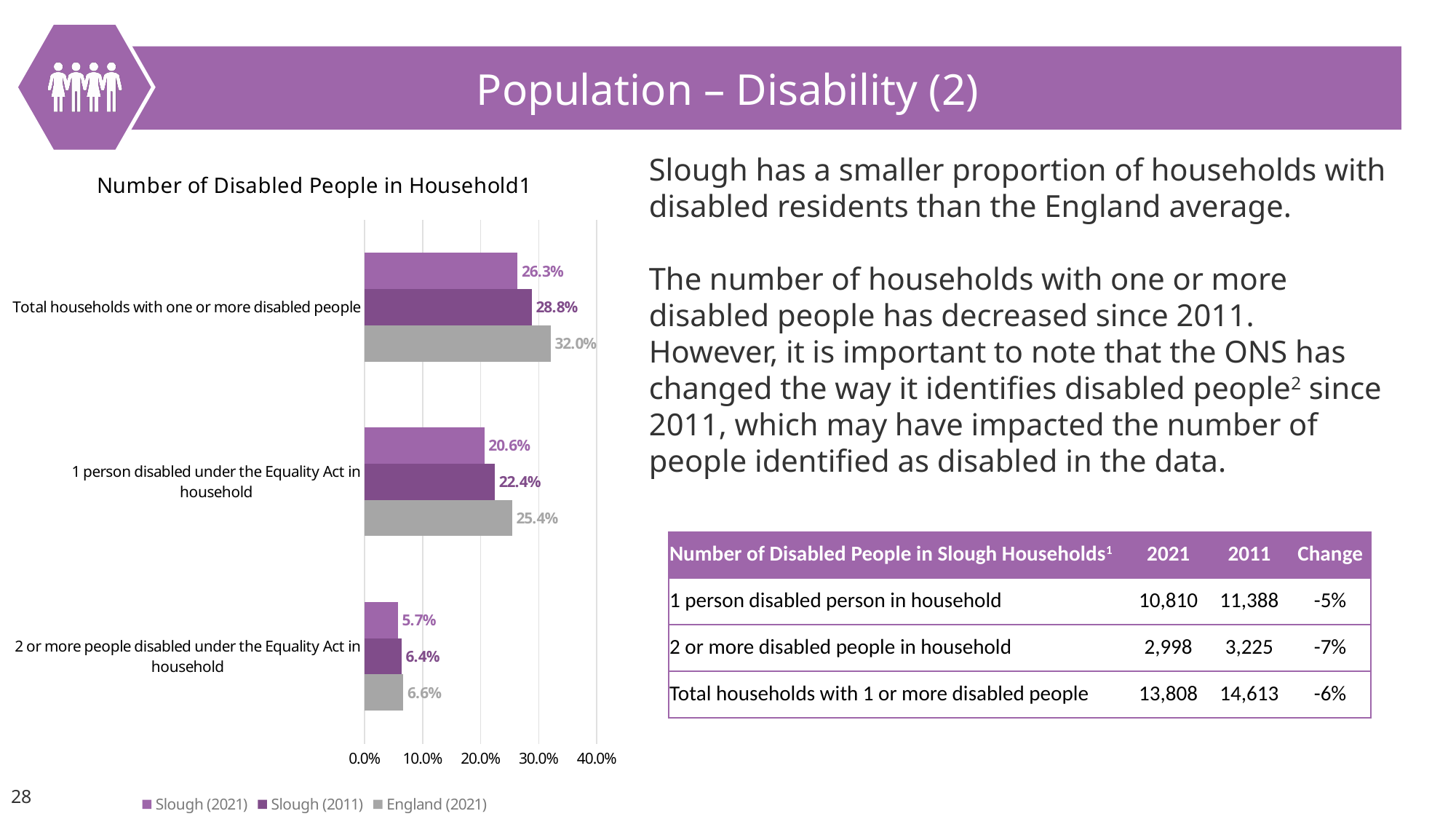
How many series does the legend list? 3 Which category has the lowest Slough (2021) value? 2 or more people disabled under the Equality Act in household Which is larger for '1 person disabled under the Equality Act in household': Slough (2021) or Slough (2011)? Slough (2011) What is the difference between the England (2021) and Slough (2021) values for 'Total households with one or more disabled people'? 5.7% What is the Slough (2021) value for 'Total households with one or more disabled people'? 26.3% How many categories are shown on the chart? 3 Is the Slough (2011) value for 'Total households with one or more disabled people' greater or less than 30.0%? less What kind of chart is shown on the slide? bar chart What is the title of the chart? Number of Disabled People in Household1 Which series has the highest value for 'Total households with one or more disabled people'? England (2021) What is the England (2021) value for '1 person disabled under the Equality Act in household'? 25.4% What is the Slough (2011) value for '2 or more people disabled under the Equality Act in household'? 6.4%